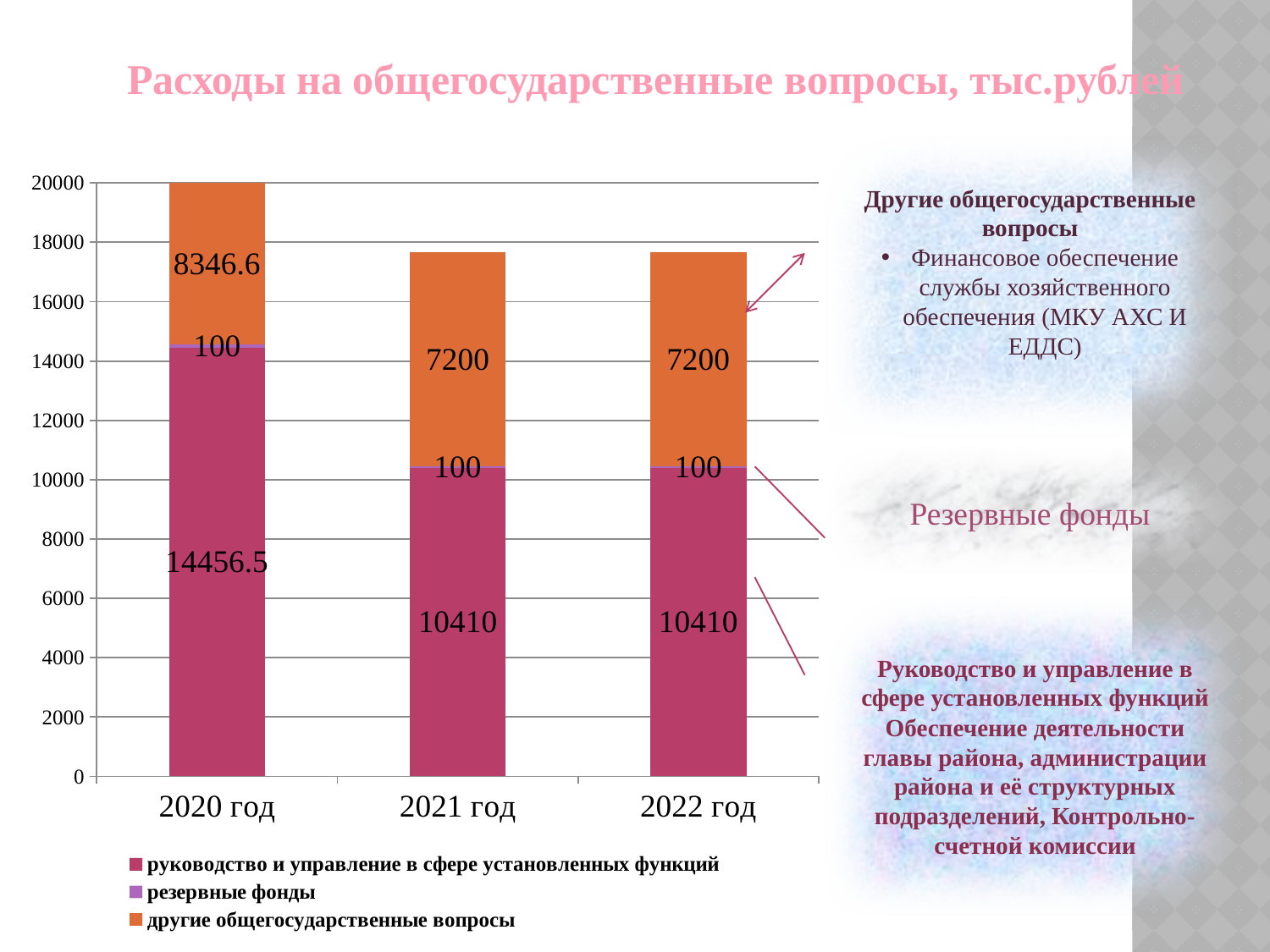
What is the difference between the другие общегосударственные вопросы values for 2020 год and 2022 год? 1146.6 What is the total of the stacked bar for 2021 год? 17710 What is the value for руководство и управление в сфере установленных функций in 2020 год? 14456.5 How many years are shown on the x axis? 3 What is the value for другие общегосударственные вопросы in 2020 год? 8346.6 What is the value for резервные фонды in 2022 год? 100 What is the difference between the руководство и управление в сфере установленных функций values for 2020 год and 2021 год? 4046.5 Which year has the highest value for другие общегосударственные вопросы? 2020 год How many series does the legend list? 3 Which year has the higher value for руководство и управление в сфере установленных функций, 2020 год or 2022 год? 2020 год What is the value for другие общегосударственные вопросы in 2021 год? 7200 What kind of chart is shown on the slide? stacked bar chart